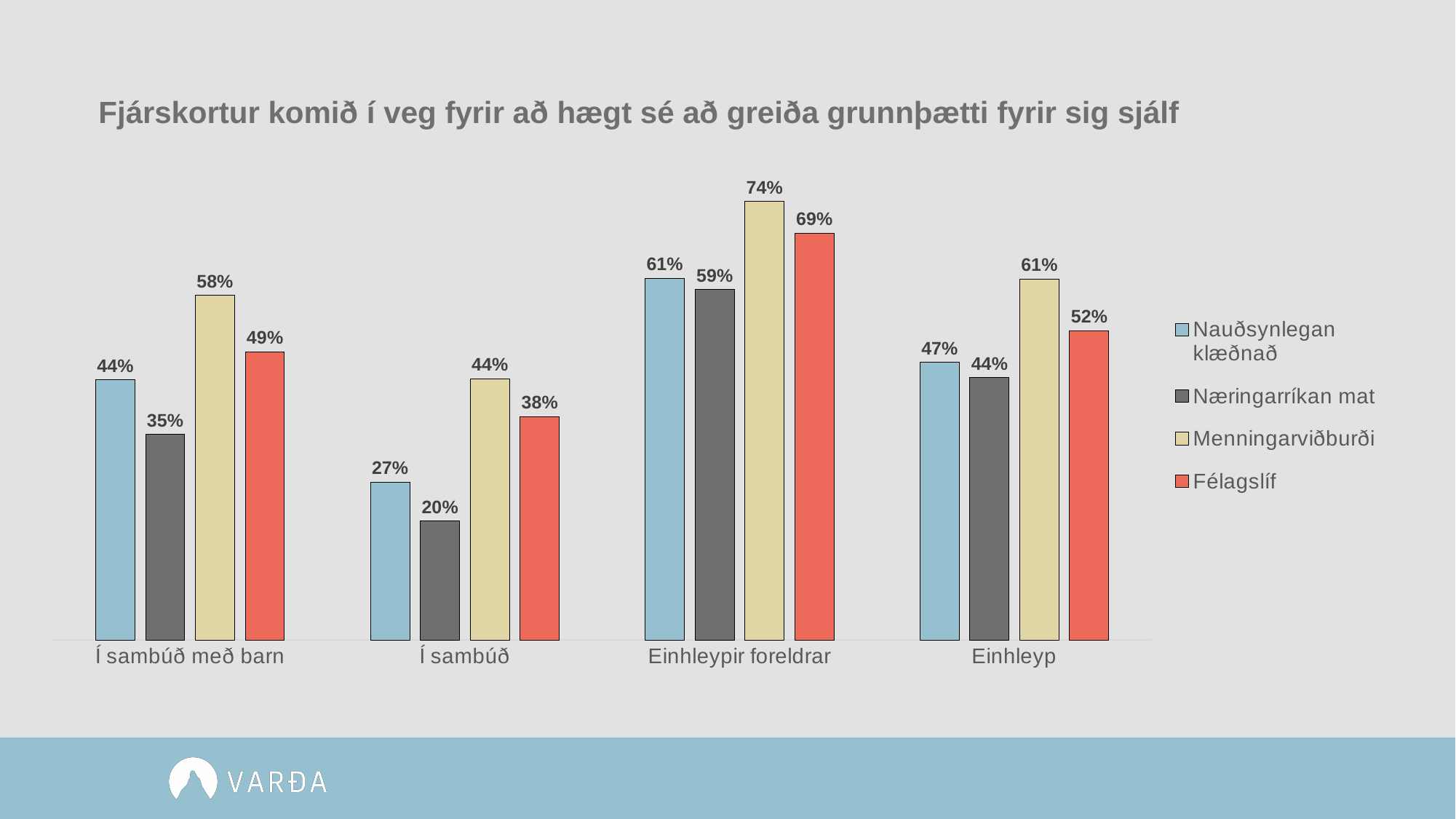
What is the value for Félagslíf in the Einhleyp category? 52% What is the value for Menningarviðburði in the Einhleypir foreldrar category? 74% Which is larger: the Félagslíf value for Einhleypir foreldrar or the Félagslíf value for Einhleyp? Einhleypir foreldrar What is the difference between the Menningarviðburði value and the Næringarríkan mat value in the Í sambúð með barn category? 23% How many series does the legend list? 4 Which category has the lowest value for Félagslíf? Í sambúð Which category has the highest value for Nauðsynlegan klæðnað? Einhleypir foreldrar What kind of chart is shown on the slide? Bar chart How many categories are shown on the x axis? 4 Which series is shown in red in the legend? Félagslíf What is the title of the chart? Fjárskortur komið í veg fyrir að hægt sé að greiða grunnþætti fyrir sig sjálf What is the value for Næringarríkan mat in the Í sambúð category? 20%